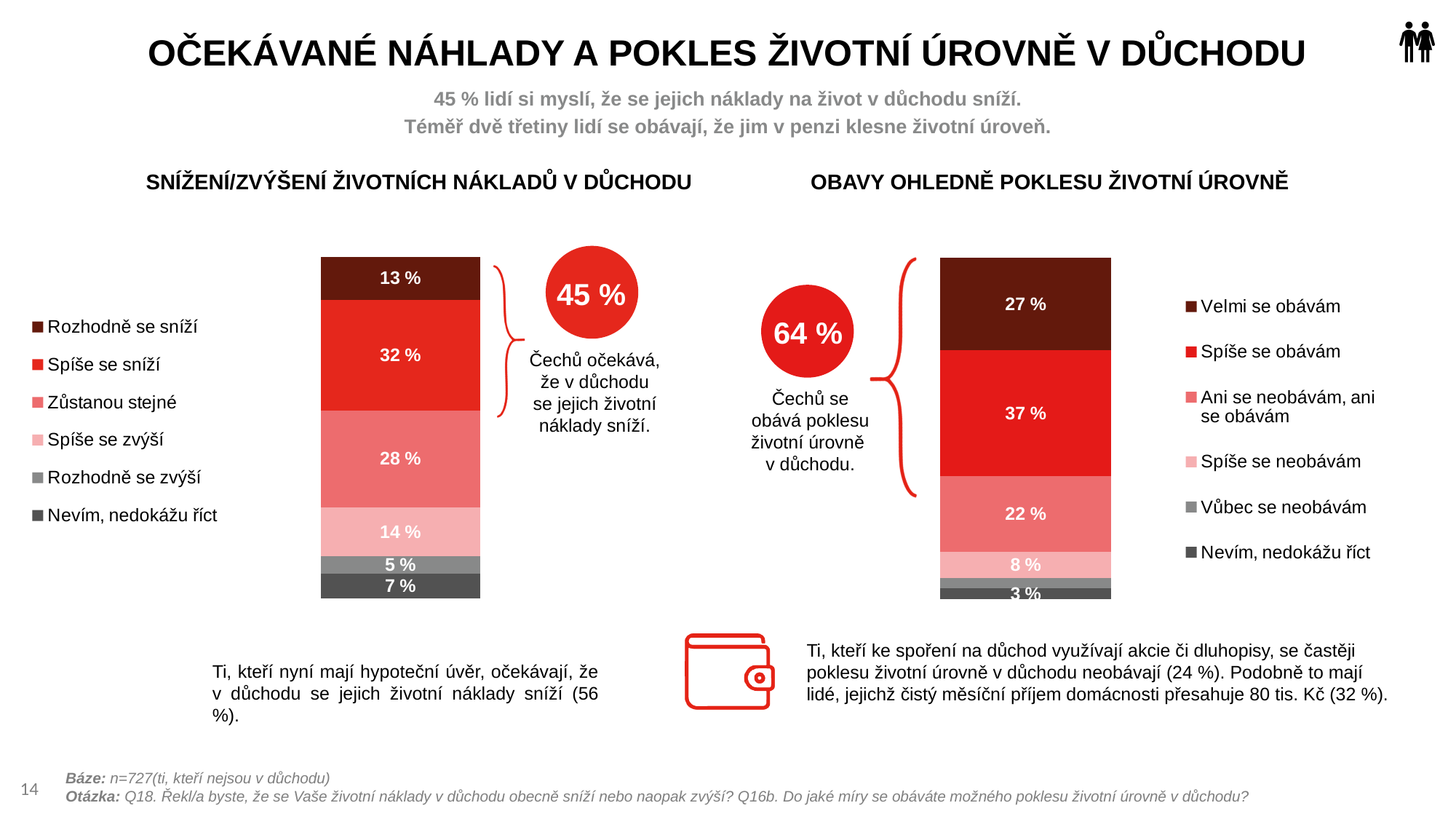
In the right chart (Obavy ohledně poklesu životní úrovně), what percentage is shown for 'Spíše se obávám'? 37 % In the right chart (Obavy ohledně poklesu životní úrovně), what is the combined share of 'Velmi se obávám' and 'Spíše se obávám'? 64 % In the left chart (Snížení/zvýšení životních nákladů v důchodu), what is the difference between 'Spíše se sníží' and 'Spíše se zvýší'? 18 % In the right chart (Obavy ohledně poklesu životní úrovně), which is larger: 'Velmi se obávám' or 'Ani se neobávám, ani se obávám'? Velmi se obávám In the right chart (Obavy ohledně poklesu životní úrovně), what percentage is shown for 'Velmi se obávám'? 27 % In the left chart (Snížení/zvýšení životních nákladů v důchodu), what percentage is shown for 'Spíše se sníží'? 32 % How many categories does the legend of the left chart (Snížení/zvýšení životních nákladů v důchodu) list? 6 In the left chart (Snížení/zvýšení životních nákladů v důchodu), what percentage is shown for 'Rozhodně se sníží'? 13 % In the left chart (Snížení/zvýšení životních nákladů v důchodu), what percentage is shown for 'Zůstanou stejné'? 28 % What type of chart is used on the left side of the slide (Snížení/zvýšení životních nákladů v důchodu)? Stacked bar chart In the right chart (Obavy ohledně poklesu životní úrovně), what percentage is shown for 'Spíše se neobávám'? 8 % In the left chart (Snížení/zvýšení životních nákladů v důchodu), which category has the largest share? Spíše se sníží